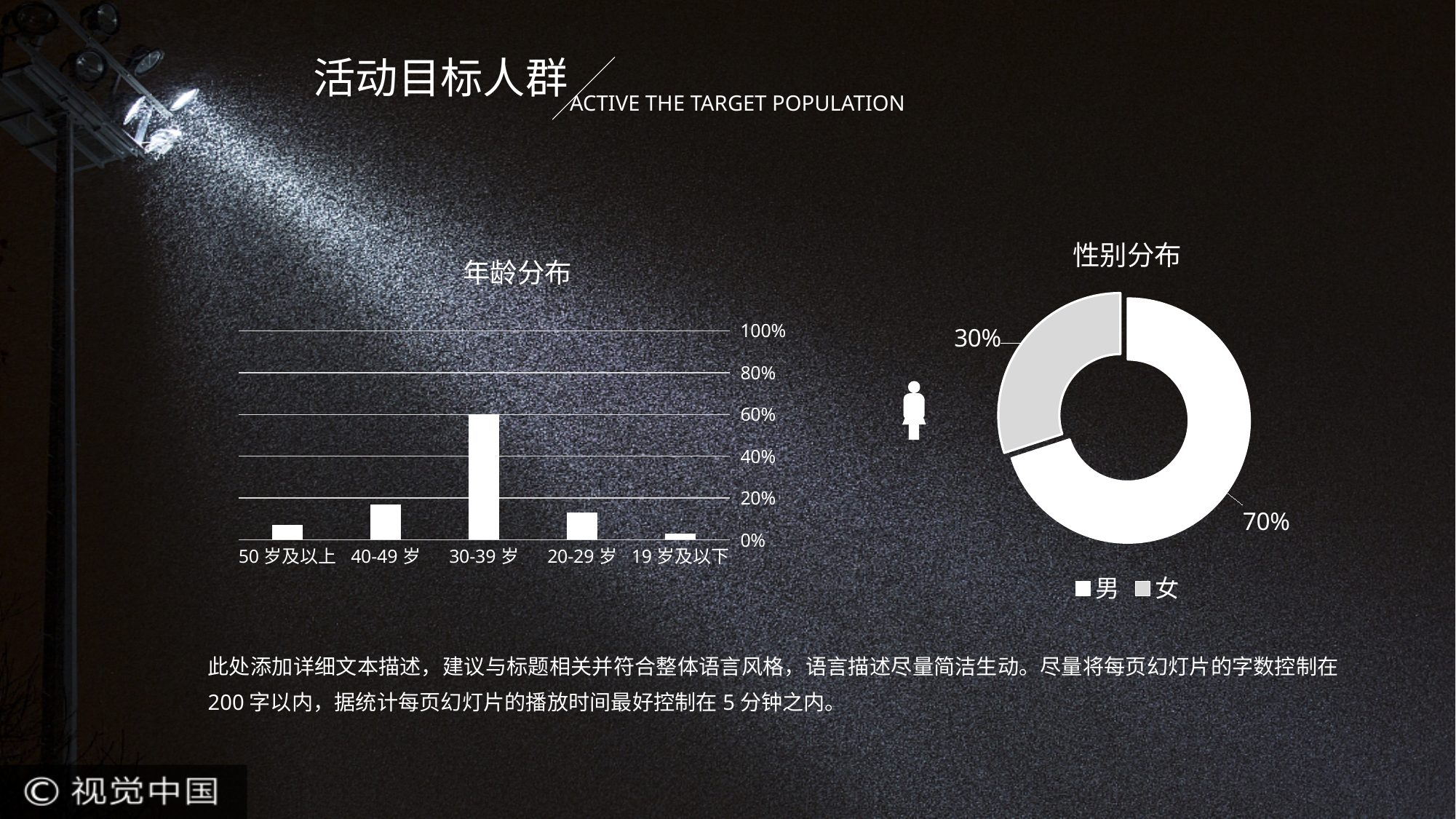
In the 年龄分布 chart, which age group has the lowest value? 19 岁及以下 How many age groups are shown in the 年龄分布 chart? 5 In the 性别分布 chart, which is larger, 男 or 女? 男 In the 性别分布 chart, what share is 女? 30% In the 年龄分布 chart, is the value for 40-49 岁 greater or less than 40%? less How many entries does the legend of the 性别分布 chart list? 2 In the 年龄分布 chart, which age group has the highest value? 30-39 岁 In the 性别分布 chart, what share is 男? 70% In the 年龄分布 chart, is the value for 30-39 岁 greater or less than 40%? greater What kind of chart is the 性别分布 chart? Donut chart What kind of chart is the 年龄分布 chart? Bar chart In the 性别分布 chart, what is the difference between the 男 and 女 shares? 40%